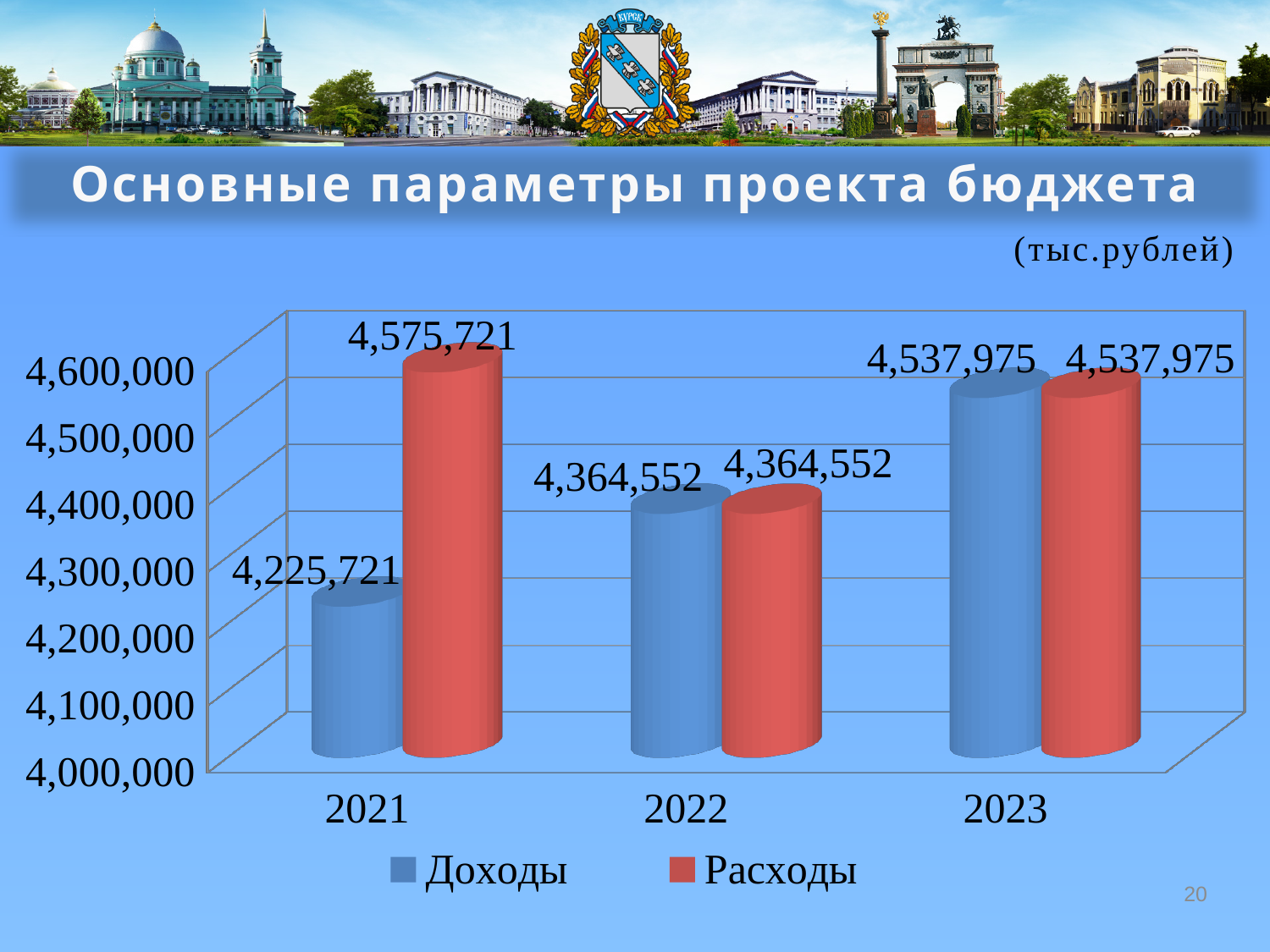
What is the value of Доходы for 2022? 4,364,552 What is the difference between Расходы and Доходы in 2021? 350,000 What is the value of Доходы for 2021? 4,225,721 What kind of chart is shown on the slide? Bar chart In which year is Расходы the lowest? 2022 What is the value of Расходы for 2021? 4,575,721 How many series does the legend list? 2 In which year is Доходы the lowest? 2021 In which year is Доходы the highest? 2023 How many years are shown on the x axis? 3 What is the value of Расходы for 2023? 4,537,975 Which is larger in 2021, Доходы or Расходы? Расходы